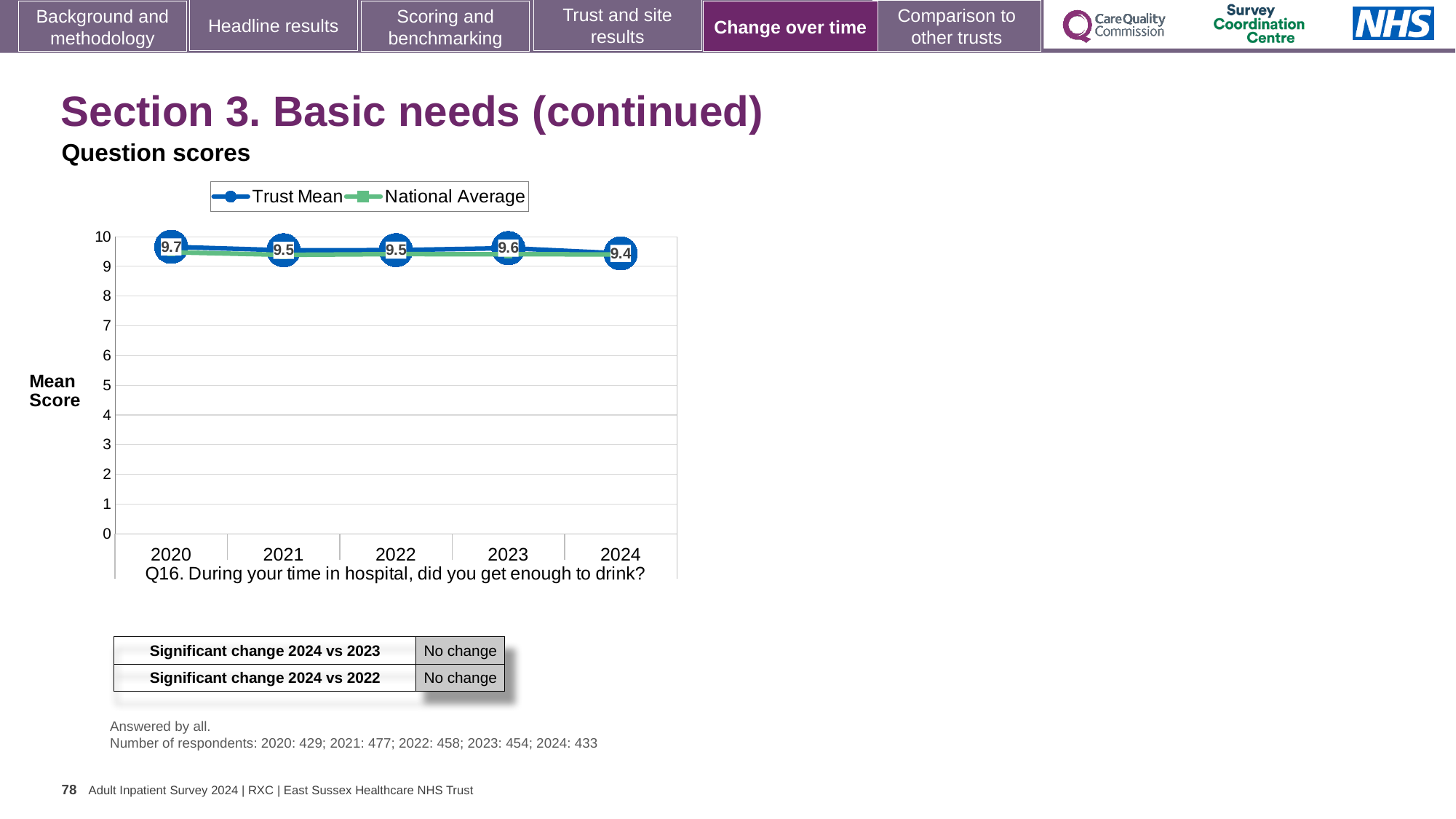
Is the Trust Mean score for 2022 greater or less than 9? greater Which year has the larger Trust Mean score, 2023 or 2024? 2023 What is the difference between the Trust Mean score in 2020 and in 2024? 0.3 What is the Trust Mean score for 2023? 9.6 What is the Trust Mean score for 2020? 9.7 Which survey question does the chart show scores for? Q16. During your time in hospital, did you get enough to drink? What is the Trust Mean score for 2024? 9.4 In which year is the Trust Mean score highest? 2020 In which year is the Trust Mean score lowest? 2024 How many series does the chart legend list? 2 How many years are shown on the x axis of the chart? 5 What kind of chart is shown on the slide? line chart